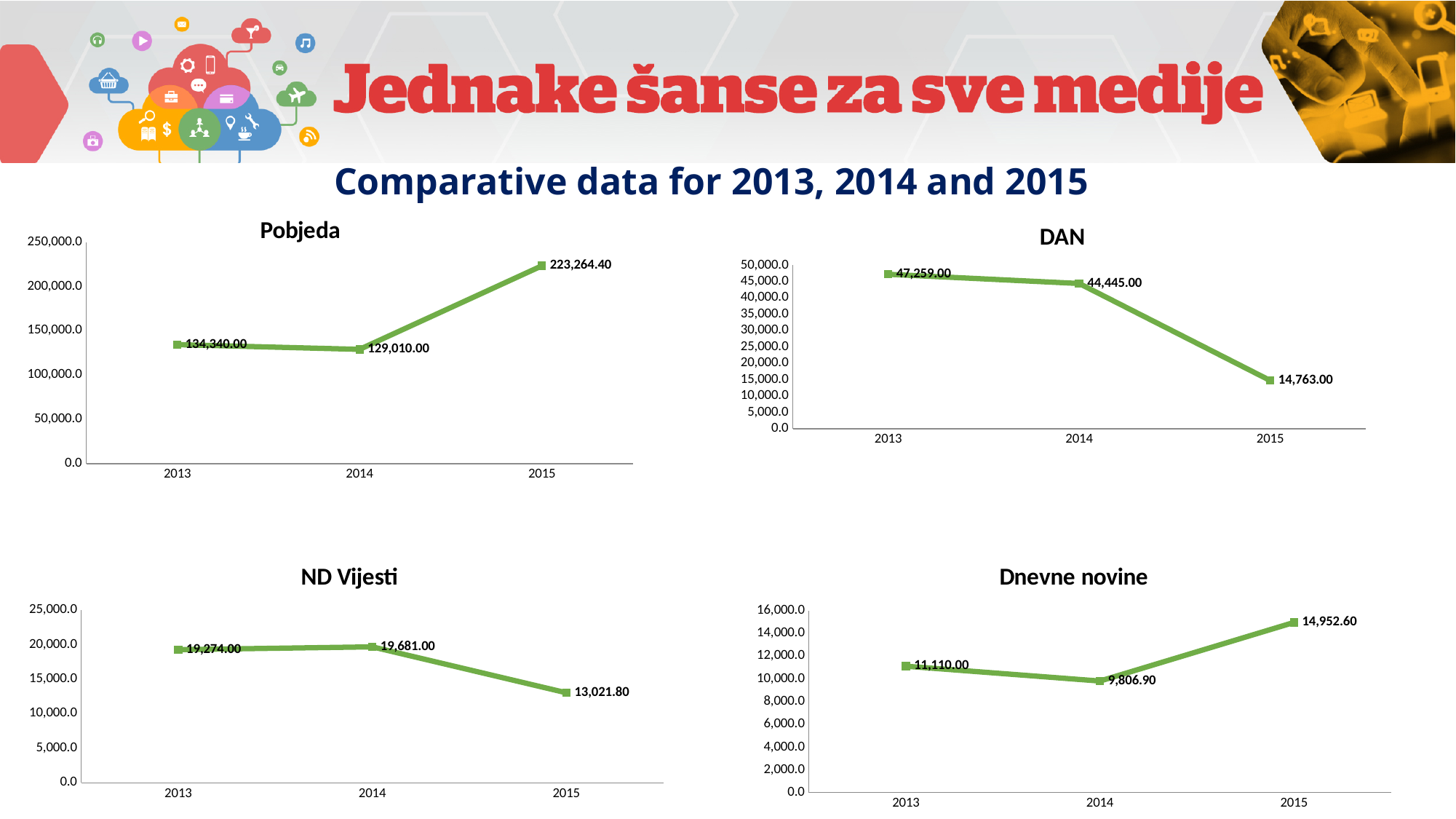
In the Pobjeda chart, which year has the highest value? 2015 How many data points are plotted in the Dnevne novine chart? 3 In the DAN chart, how much higher is the 2013 value than the 2015 value? 32,496.00 In the Dnevne novine chart, what is the value for 2014? 9,806.90 What kind of chart is the DAN chart? line chart In the Dnevne novine chart, is the value for 2013 larger or smaller than the value for 2014? larger In the Pobjeda chart, what is the value for 2015? 223,264.40 In the ND Vijesti chart, what is the value for 2015? 13,021.80 In the ND Vijesti chart, is the value for 2015 greater or less than 15,000.0? less In the Pobjeda chart, what is the difference between the 2015 and 2014 values? 94,254.40 In the DAN chart, what is the value for 2013? 47,259.00 In the DAN chart, which year has the lowest value? 2015